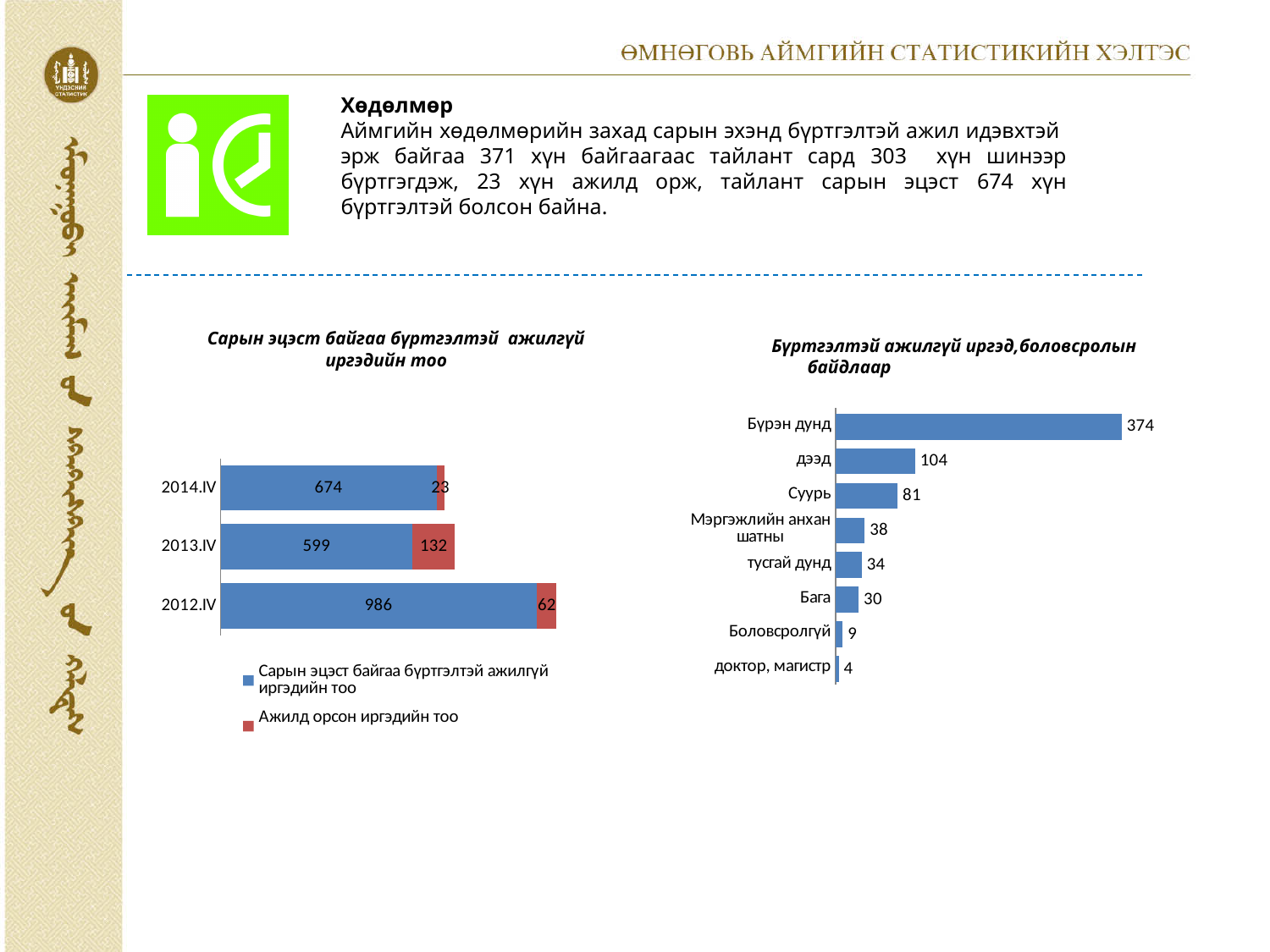
In the chart 'Бүртгэлтэй ажилгүй иргэд, боловсролын байдлаар', what is the value for 'дээд'? 104 What kind of chart is 'Бүртгэлтэй ажилгүй иргэд, боловсролын байдлаар'? Bar chart In the chart 'Сарын эцэст байгаа бүртгэлтэй ажилгүй иргэдийн тоо', what is the value of 'Сарын эцэст байгаа бүртгэлтэй ажилгүй иргэдийн тоо' for 2014.IV? 674 In the chart 'Сарын эцэст байгаа бүртгэлтэй ажилгүй иргэдийн тоо', how many series does the legend list? 2 In the chart 'Бүртгэлтэй ажилгүй иргэд, боловсролын байдлаар', which category has the highest value? Бүрэн дунд In the chart 'Бүртгэлтэй ажилгүй иргэд, боловсролын байдлаар', which category has the lowest value? доктор, магистр In the chart 'Бүртгэлтэй ажилгүй иргэд, боловсролын байдлаар', what is the difference between the values for 'Бүрэн дунд' and 'Суурь'? 293 In the chart 'Бүртгэлтэй ажилгүй иргэд, боловсролын байдлаар', how many categories are shown? 8 In the chart 'Сарын эцэст байгаа бүртгэлтэй ажилгүй иргэдийн тоо', what is the total of the stacked bar for 2012.IV? 1048 In the chart 'Сарын эцэст байгаа бүртгэлтэй ажилгүй иргэдийн тоо', what is the value of 'Ажилд орсон иргэдийн тоо' for 2013.IV? 132 In the chart 'Сарын эцэст байгаа бүртгэлтэй ажилгүй иргэдийн тоо', what is the difference between the 'Ажилд орсон иргэдийн тоо' values for 2013.IV and 2014.IV? 109 In the chart 'Сарын эцэст байгаа бүртгэлтэй ажилгүй иргэдийн тоо', which period has the highest value of 'Сарын эцэст байгаа бүртгэлтэй ажилгүй иргэдийн тоо'? 2012.IV